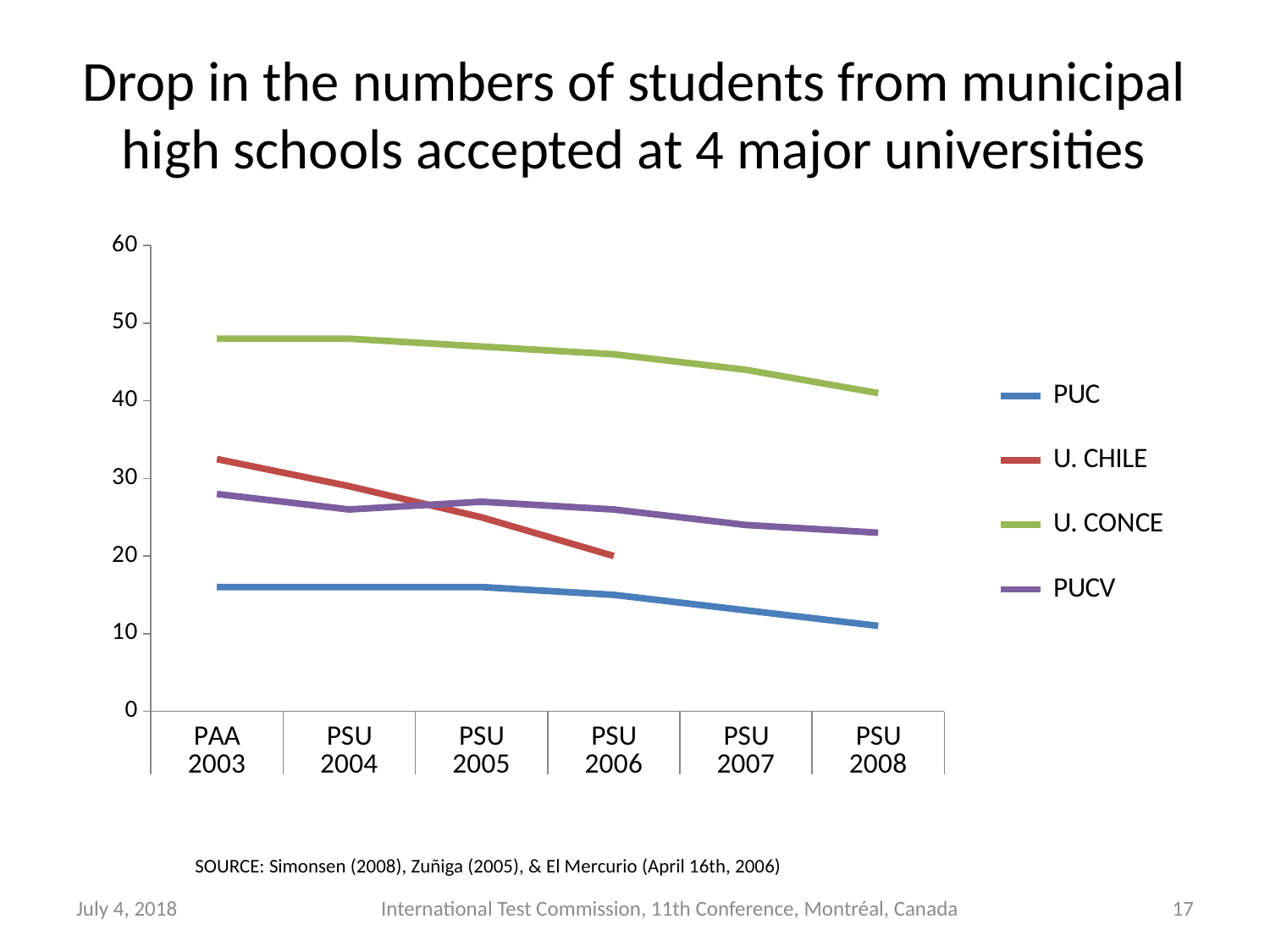
How many series does the legend list? 4 Which university has the lowest value at PSU 2008? PUC Is the value for PUCV at PSU 2008 greater or less than 20? greater Is the value for U. CONCE at PAA 2003 greater or less than 40? greater Is the value for PUC at PAA 2003 greater or less than 20? less At PAA 2003, which is larger: the value for U. CHILE or the value for PUCV? U. CHILE What kind of chart is shown on the slide? line chart Which series is shown in red in the legend? U. CHILE Which university has the highest value at PAA 2003? U. CONCE Does the U. CONCE line rise or fall from PAA 2003 to PSU 2008? fall